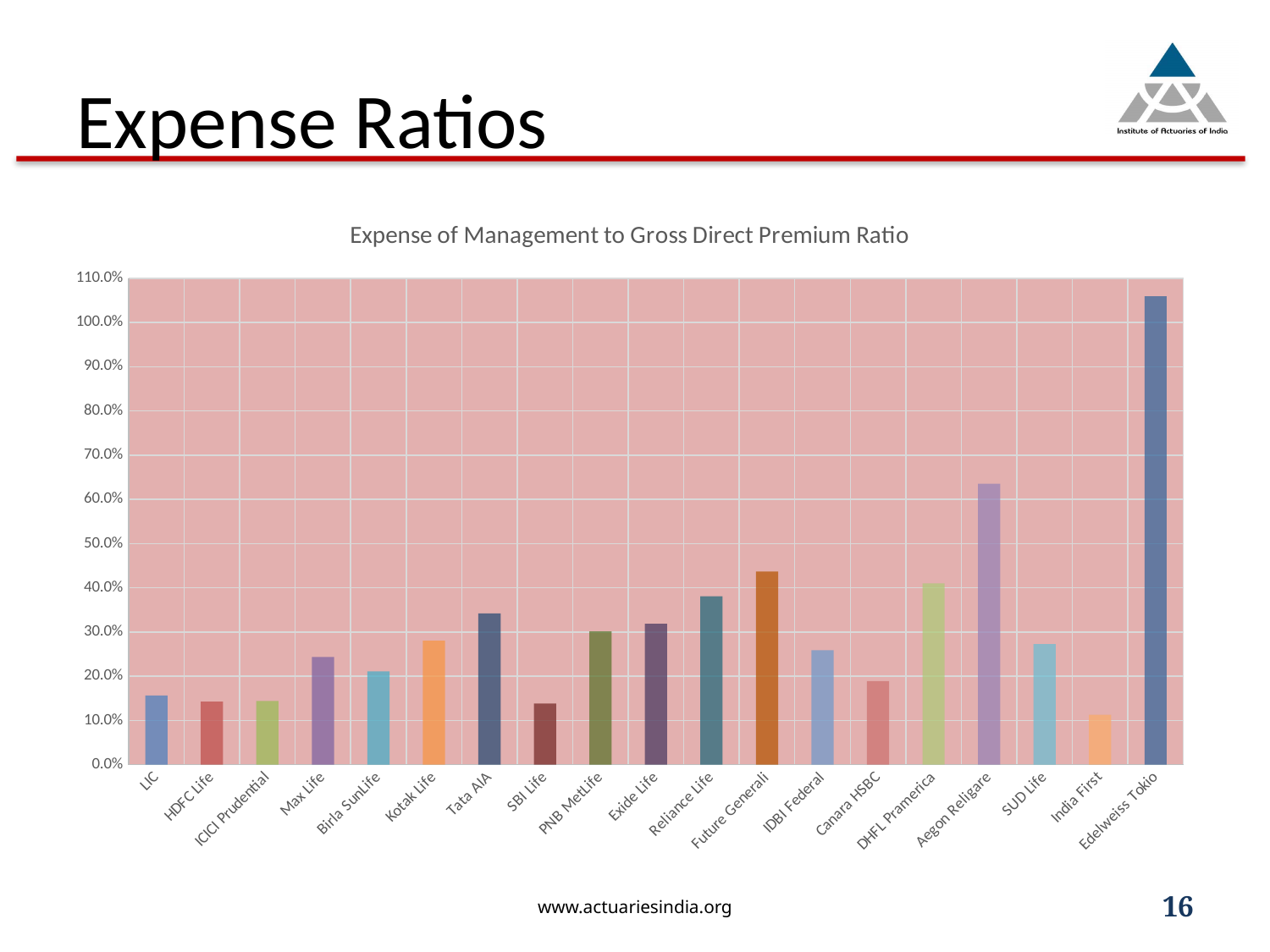
What type of chart is shown on the slide? Bar chart Which insurer has the lowest expense of management to gross direct premium ratio? India First Is the value for Future Generali greater or less than 40.0%? greater Is the value for LIC greater or less than 20.0%? less Is the value for Aegon Religare greater or less than 60.0%? greater Which insurer has the highest expense of management to gross direct premium ratio? Edelweiss Tokio Which has a higher expense ratio, Aegon Religare or Future Generali? Aegon Religare How many insurers (categories) are plotted in the chart? 19 Which has a higher expense ratio, Reliance Life or Exide Life? Reliance Life What is the title of the chart? Expense of Management to Gross Direct Premium Ratio